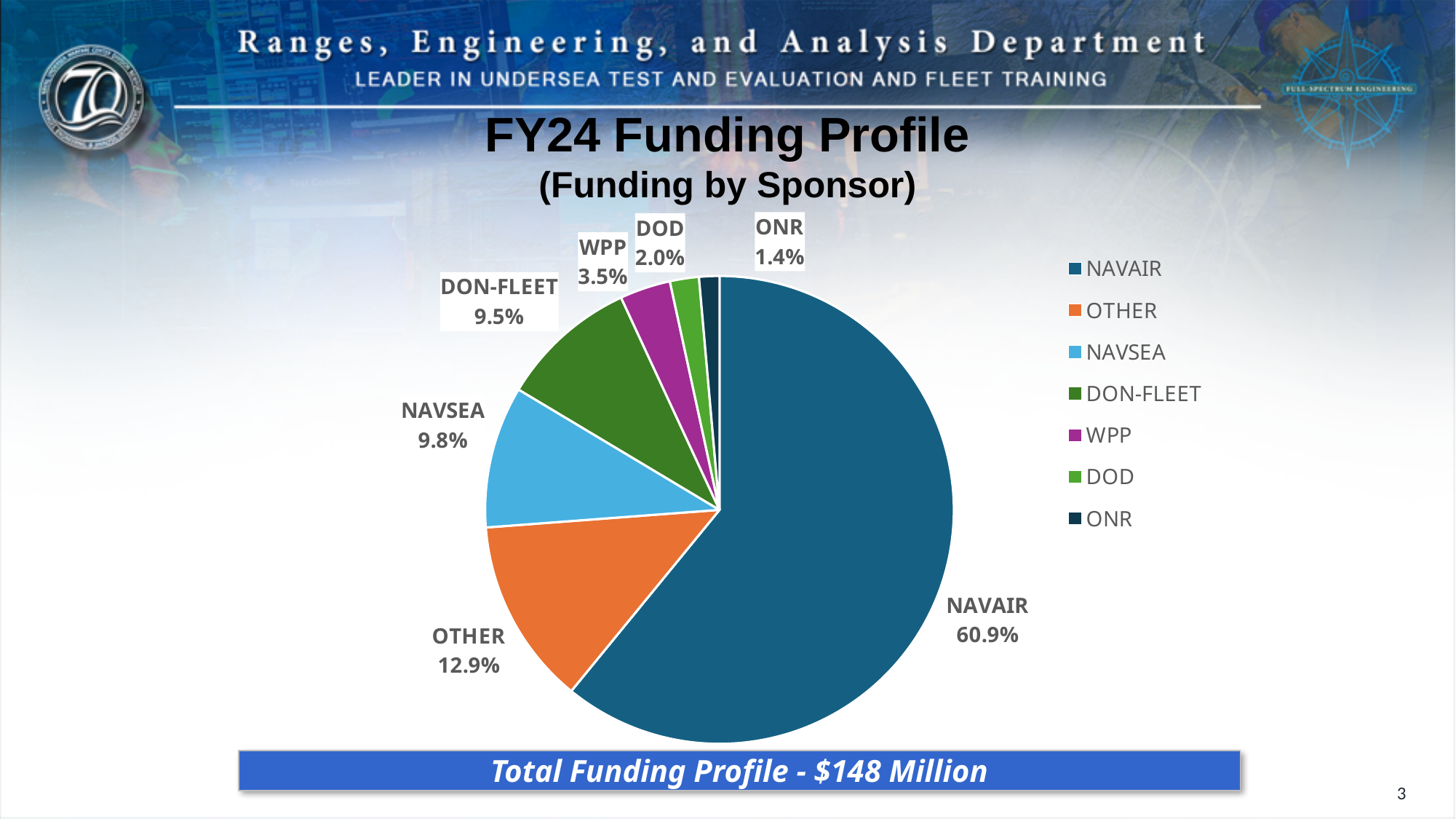
What percentage of funding is attributed to OTHER sponsors? 12.9% Which sponsor has the smallest share of FY24 funding? ONR How many sponsor categories are shown in the pie chart? 7 What percentage of funding comes from DON-FLEET? 9.5% Which sponsor has the largest share of FY24 funding? NAVAIR What is the NAVSEA share of the funding profile? 9.8% What is the difference in percentage points between the NAVAIR and OTHER shares? 48.0% What is the WPP share of funding? 3.5% Which has a larger share of funding, DOD or ONR? DOD What total funding amount is stated below the chart? $148 Million What share of FY24 funding comes from NAVAIR? 60.9% What kind of chart is shown on the slide? Pie chart